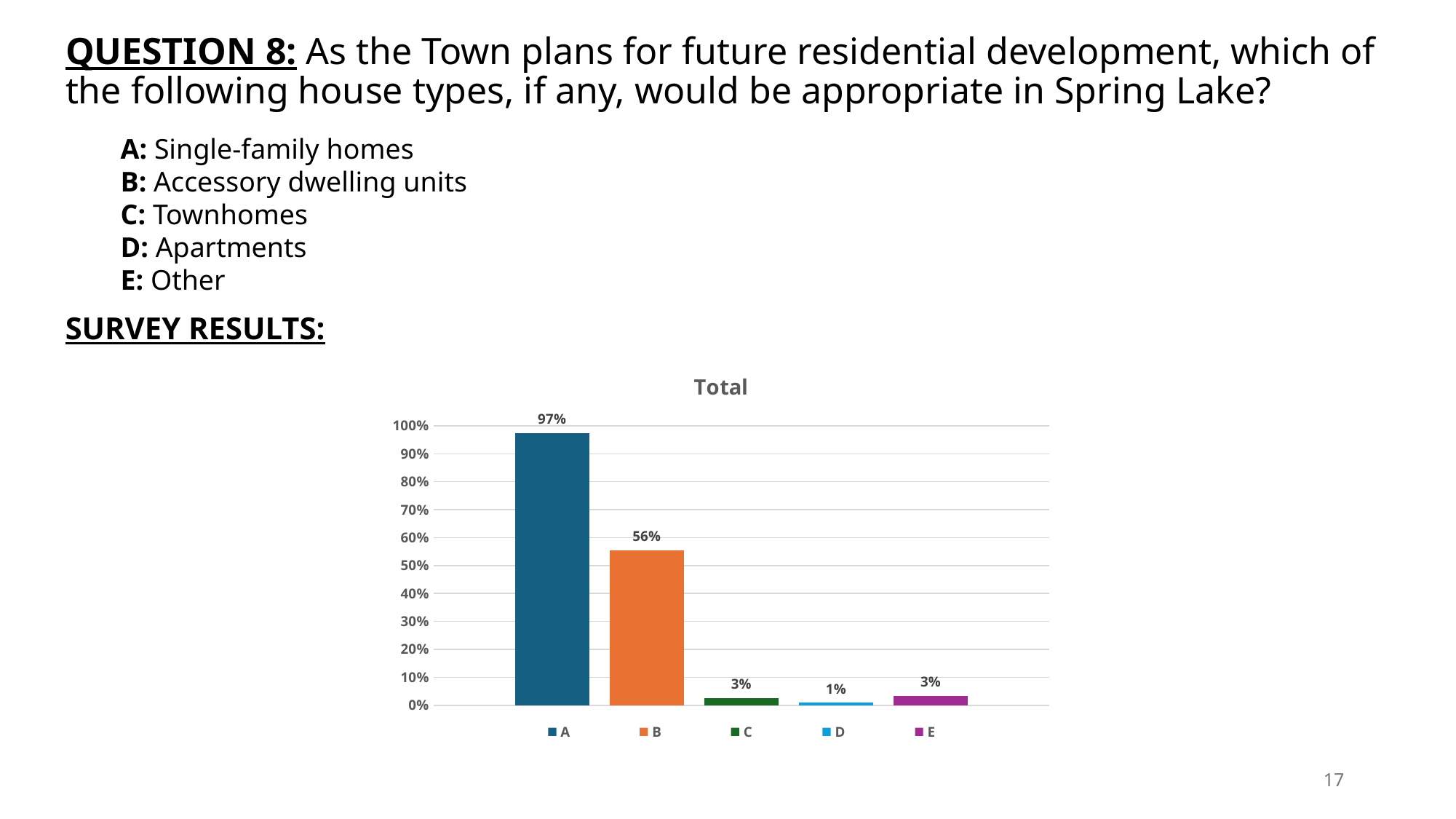
What is the value for A in the chart? 97% What is the title of the chart? Total What is the difference between the values for A and B? 41% Which category has the highest value? A What kind of chart is shown on the slide? bar chart How many categories are shown in the chart? 5 Which category has the lowest value? D What is the value for B in the chart? 56% Is the value for B greater or less than 50%? greater What is the value for D in the chart? 1% What is the value for C in the chart? 3% Which is larger, the value for B or the value for E? B